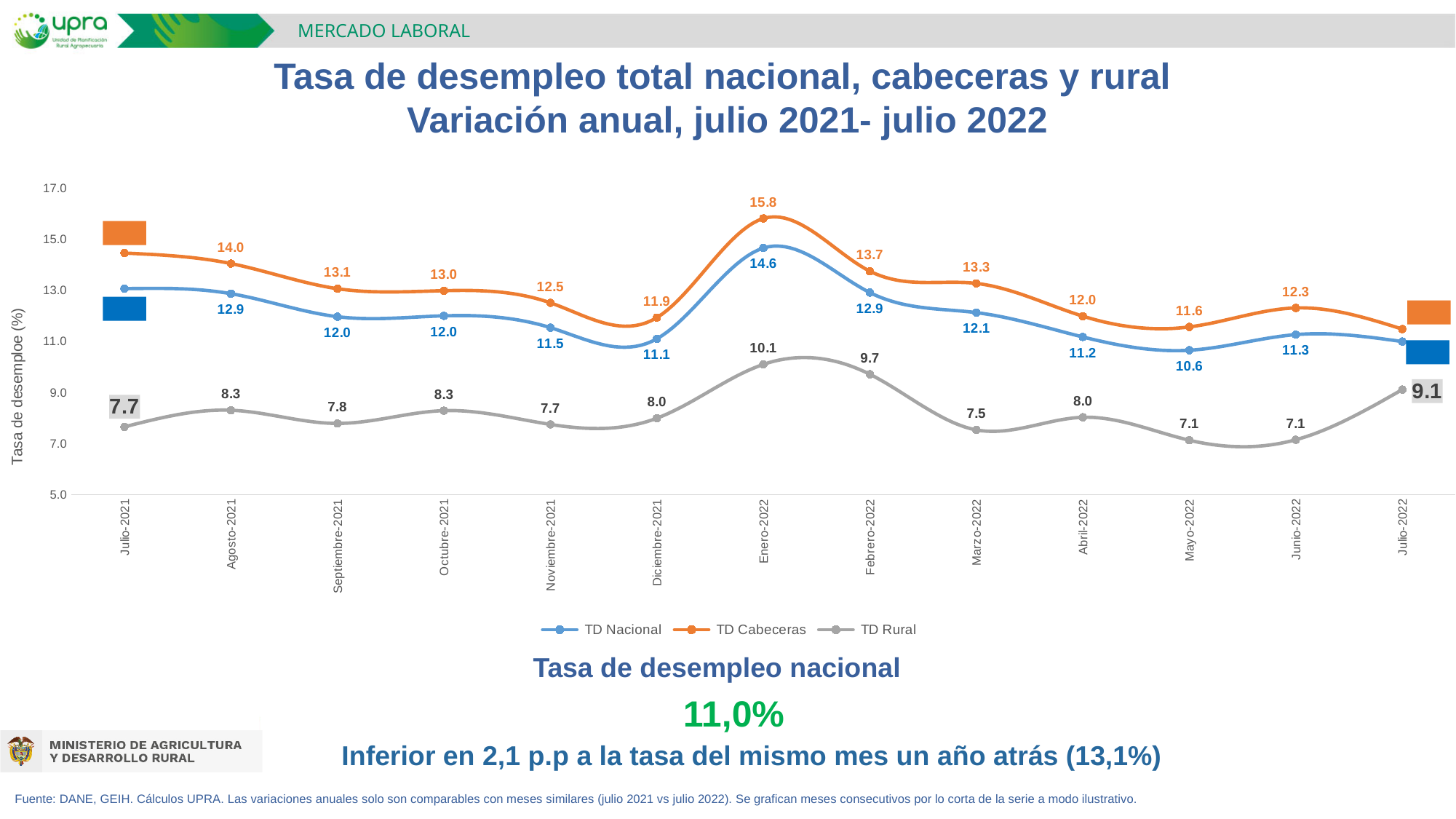
Which is larger for TD Rural: Agosto-2021 or Septiembre-2021? Agosto-2021 What is the difference between TD Cabeceras in Enero-2022 and Febrero-2022? 2.1 How many months are plotted along the x axis? 13 In which month does TD Nacional reach its highest value? Enero-2022 How many series does the legend list? 3 Is the value for TD Cabeceras in Julio-2021 greater or less than 13.0? greater Does TD Cabeceras rise or fall from Enero-2022 to Mayo-2022? fall What is the value of TD Nacional in Mayo-2022? 10.6 What kind of chart is shown on the slide? line chart In which month is TD Nacional at its lowest labelled value? Mayo-2022 What is the value of TD Rural in Julio-2022? 9.1 What is the value of TD Cabeceras in Enero-2022? 15.8